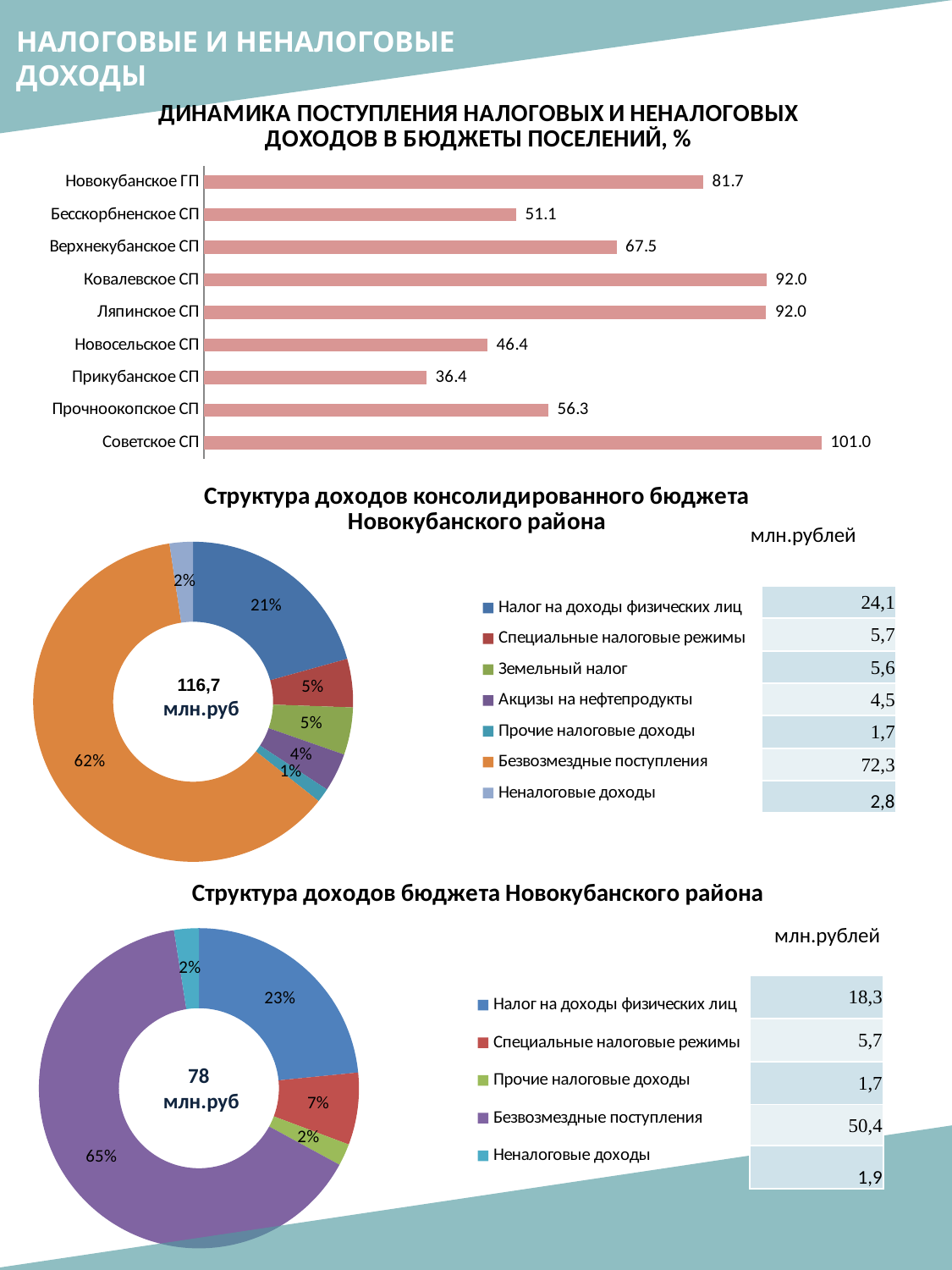
In the bar chart 'Динамика поступления налоговых и неналоговых доходов в бюджеты поселений, %', which settlement has the lowest value? Прикубанское СП How many categories does the legend list in the chart 'Структура доходов консолидированного бюджета Новокубанского района'? 7 In the chart 'Структура доходов консолидированного бюджета Новокубанского района', what is the value in млн.рублей for Налог на доходы физических лиц? 24,1 In the bar chart 'Динамика поступления налоговых и неналоговых доходов в бюджеты поселений, %', what is the difference between the values for Ковалевское СП and Новосельское СП? 45.6 How many settlements are shown in the bar chart 'Динамика поступления налоговых и неналоговых доходов в бюджеты поселений, %'? 9 In the bar chart 'Динамика поступления налоговых и неналоговых доходов в бюджеты поселений, %', what is the value for Новокубанское ГП? 81.7 In the chart 'Структура доходов бюджета Новокубанского района', what is the value in млн.рублей for Безвозмездные поступления? 50,4 What type of chart is 'Динамика поступления налоговых и неналоговых доходов в бюджеты поселений, %'? Bar chart In the chart 'Структура доходов бюджета Новокубанского района', what total is shown in the centre of the doughnut? 78 млн.руб In the bar chart 'Динамика поступления налоговых и неналоговых доходов в бюджеты поселений, %', which settlement has the highest value? Советское СП In the chart 'Структура доходов консолидированного бюджета Новокубанского района', what share of the pie is Безвозмездные поступления? 62% In the bar chart 'Динамика поступления налоговых и неналоговых доходов в бюджеты поселений, %', which is larger: the value for Верхнекубанское СП or Бесскорбненское СП? Верхнекубанское СП